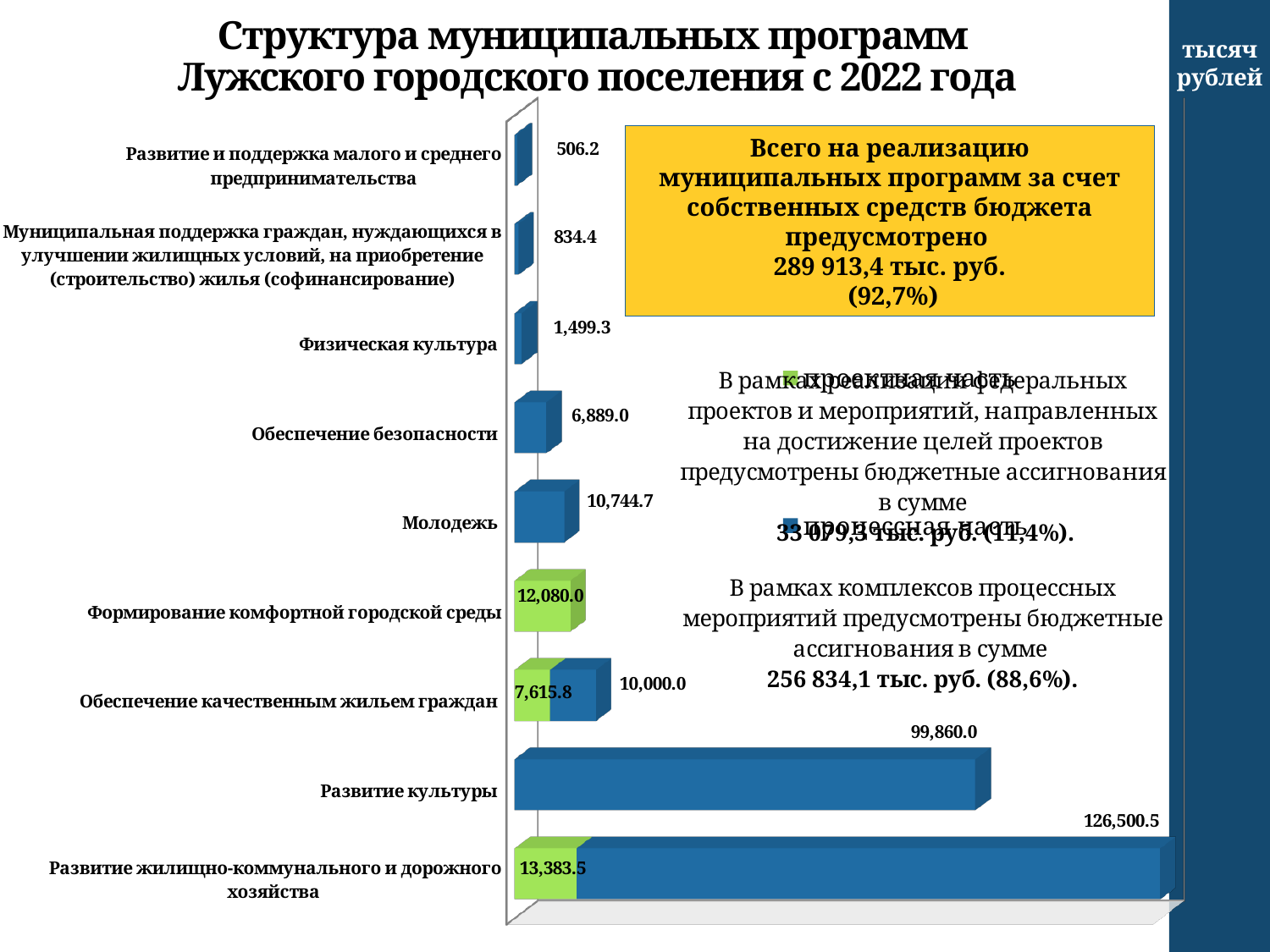
How many series does the legend list? 2 Which category has the smallest value on the chart? Развитие и поддержка малого и среднего предпринимательства What is the value shown for Молодежь? 10,744.7 What is the value shown for Развитие культуры? 99,860.0 What is the value of the проектная часть (green) segment for Обеспечение качественным жильем граждан? 7,615.8 What is the difference between the values for Развитие культуры and Молодежь? 89,115.3 What kind of chart is shown on the slide? Bar chart Which category has the largest bar on the chart? Развитие жилищно-коммунального и дорожного хозяйства What is the total of the stacked bar for Обеспечение качественным жильем граждан? 17,615.8 Which is larger, the value for Обеспечение безопасности or for Физическая культура? Обеспечение безопасности How many categories are shown on the chart? 9 What is the value of the процессная часть (blue) segment for Развитие жилищно-коммунального и дорожного хозяйства? 126,500.5